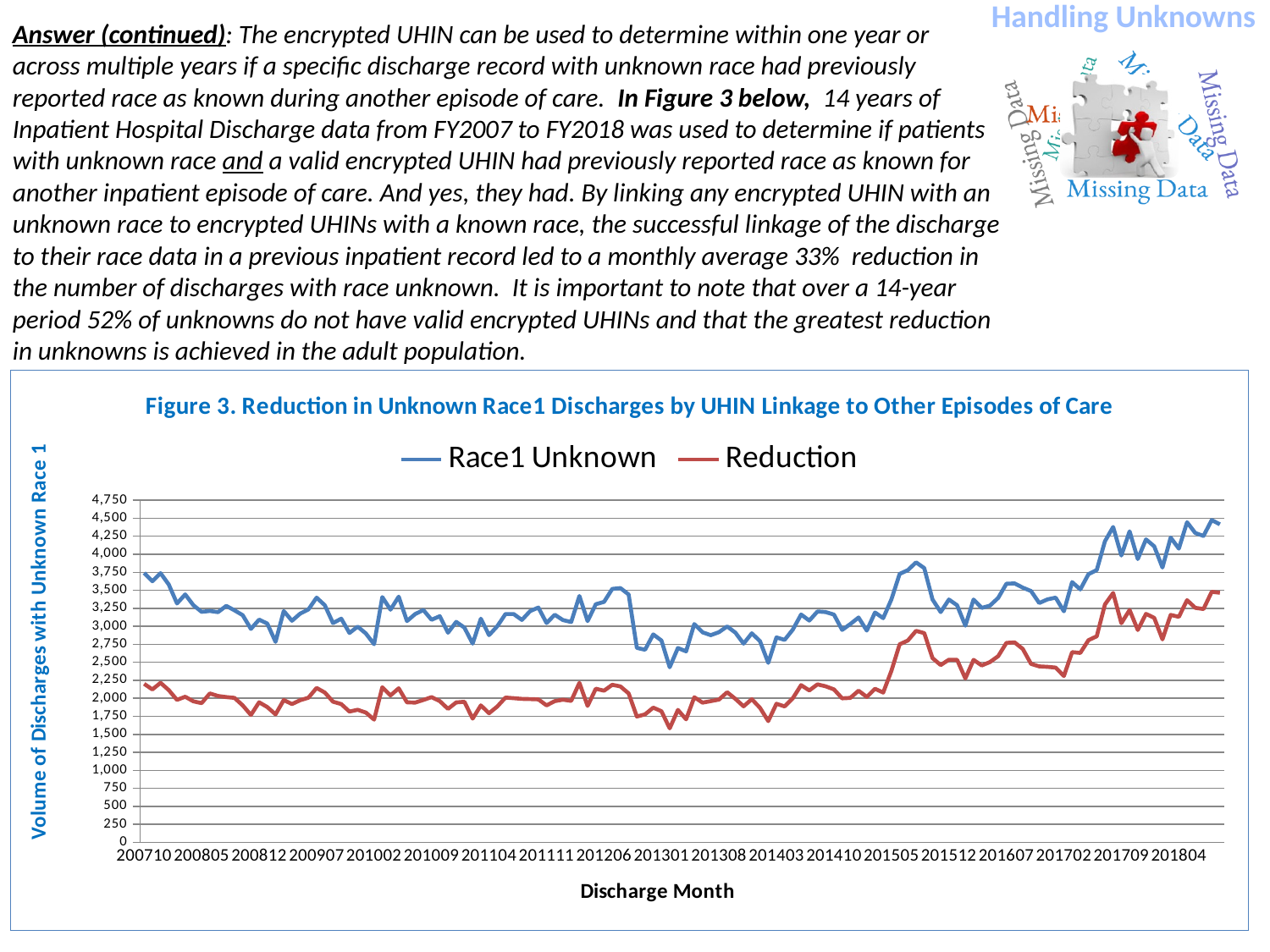
What kind of chart is shown in Figure 3? Line chart In Figure 3, is the Race1 Unknown value at 200710 greater or less than 3,500? greater How many series does the legend of Figure 3 list? 2 In Figure 3, does the Reduction series generally rise or fall between 201410 and 201804? Rise In Figure 3, which series has the higher value at 201505, Race1 Unknown or Reduction? Race1 Unknown What are the two series named in the legend of Figure 3? Race1 Unknown and Reduction What is the title of the y axis in Figure 3? Volume of Discharges with Unknown Race 1 In Figure 3, is the Reduction value at 200710 greater or less than 2,000? greater